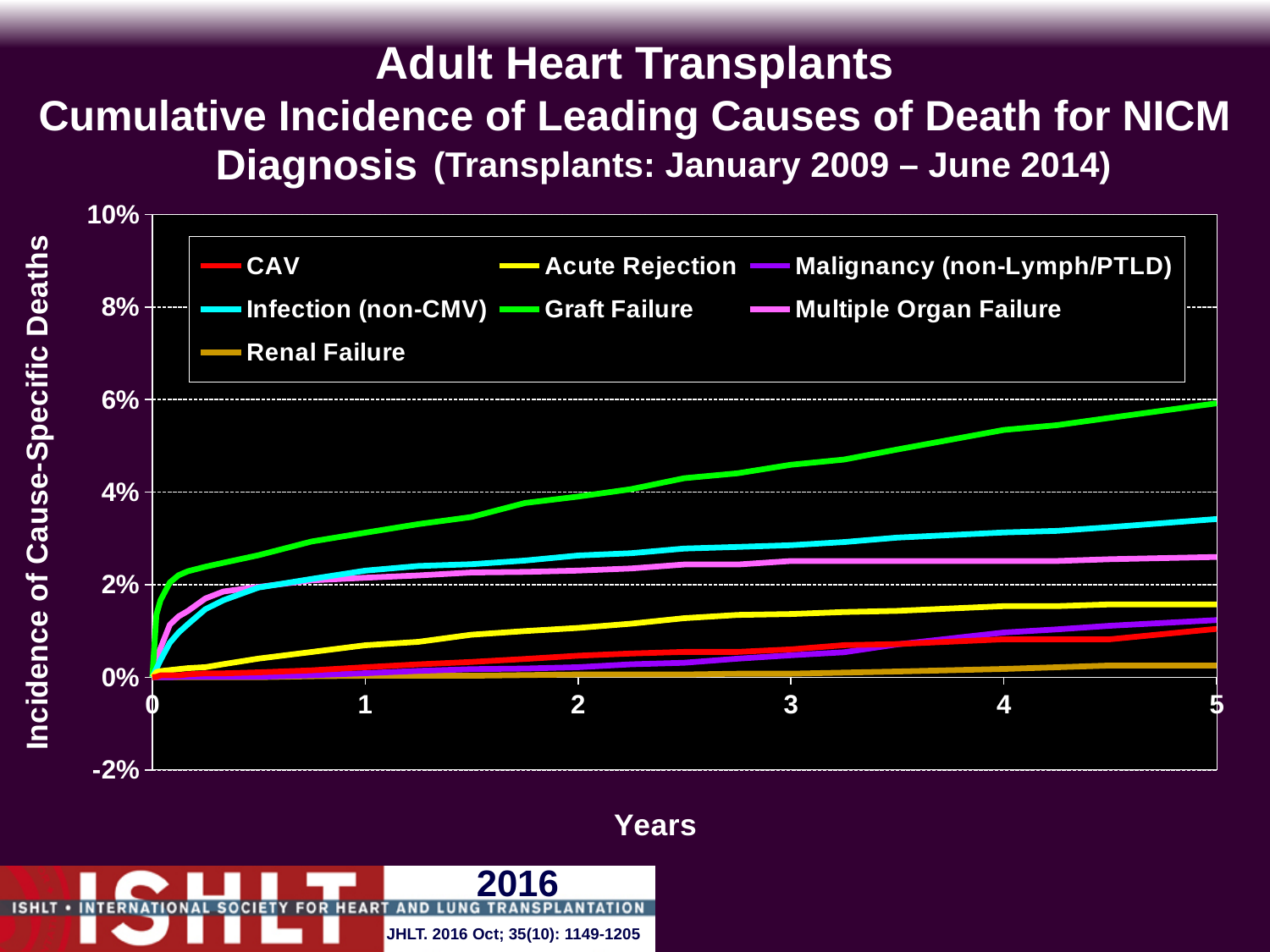
What is the label of the x axis? Years How many series does the legend list? 7 What colour is the Graft Failure line in the legend? Green Does the Graft Failure line rise or fall as years increase? Rises Is the value for Acute Rejection at 5 years greater or less than 2%? less At 5 years, which is larger: the value for Infection (non-CMV) or the value for Multiple Organ Failure? Infection (non-CMV) Is the value for Infection (non-CMV) at 5 years greater or less than 2%? greater Which cause of death has the lowest cumulative incidence at 5 years? Renal Failure What kind of chart is shown on the slide? Line chart Is the value for Graft Failure at 1 year greater or less than 4%? less Which cause of death has the highest cumulative incidence at 5 years? Graft Failure